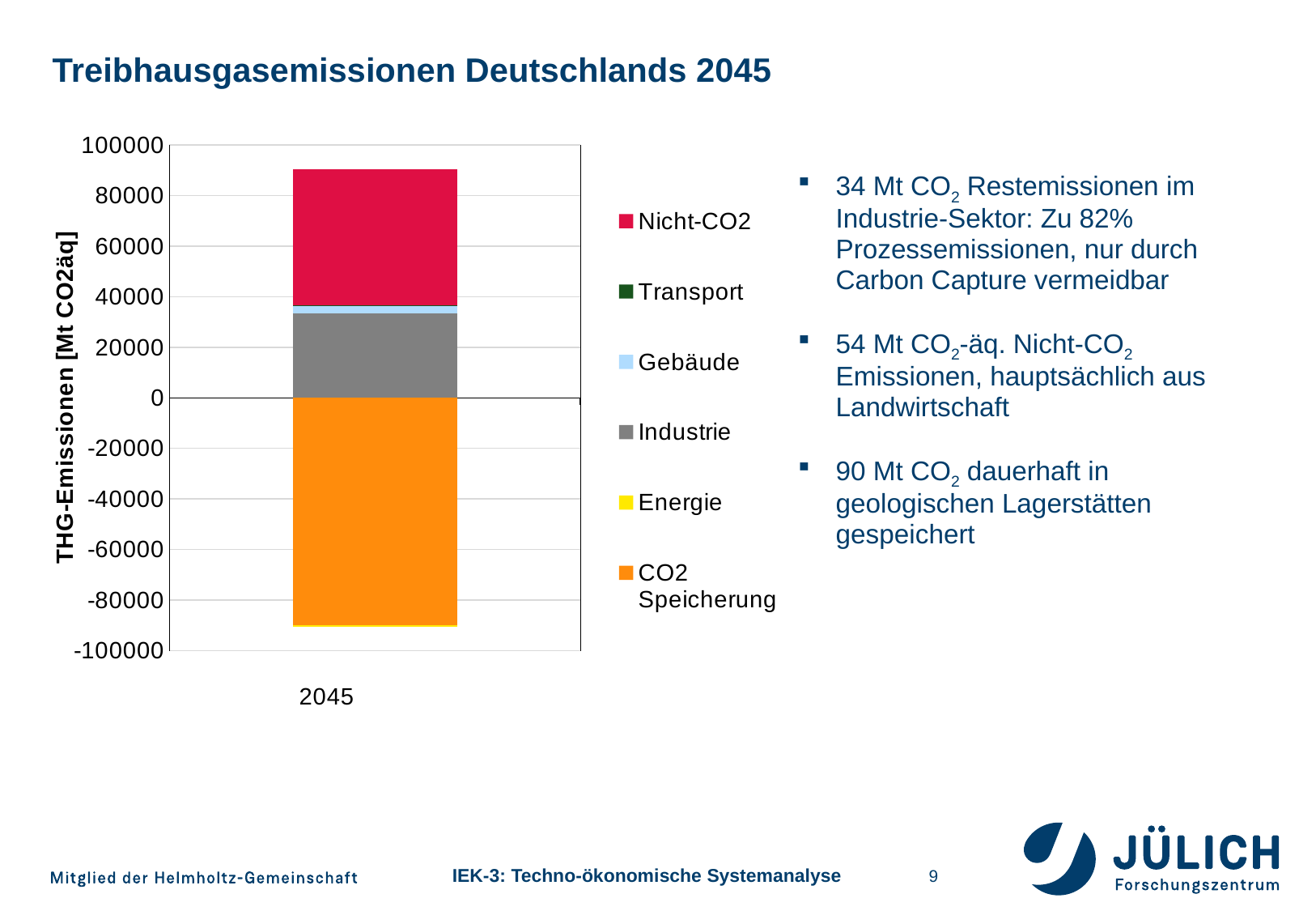
Which series is shown in orange in the chart legend? CO2 Speicherung Which series has the largest positive segment in the 2045 bar? Nicht-CO2 What is the only category label on the x axis of the chart? 2045 Does the top of the stacked positive emissions in 2045 reach greater or less than 80000? greater Which is larger in 2045, the Nicht-CO2 segment or the Gebäude segment? Nicht-CO2 Is the value for CO2 Speicherung in 2045 greater or less than -80000? less How many series does the chart legend list? 6 Is the Industrie segment in 2045 greater or less than 20000? greater Which is larger in 2045, the Industrie segment or the Gebäude segment? Industrie How many categories are shown on the x axis of the chart? 1 What kind of chart is shown on the slide? Stacked bar chart What is the label of the y axis of the chart? THG-Emissionen [Mt CO2äq]